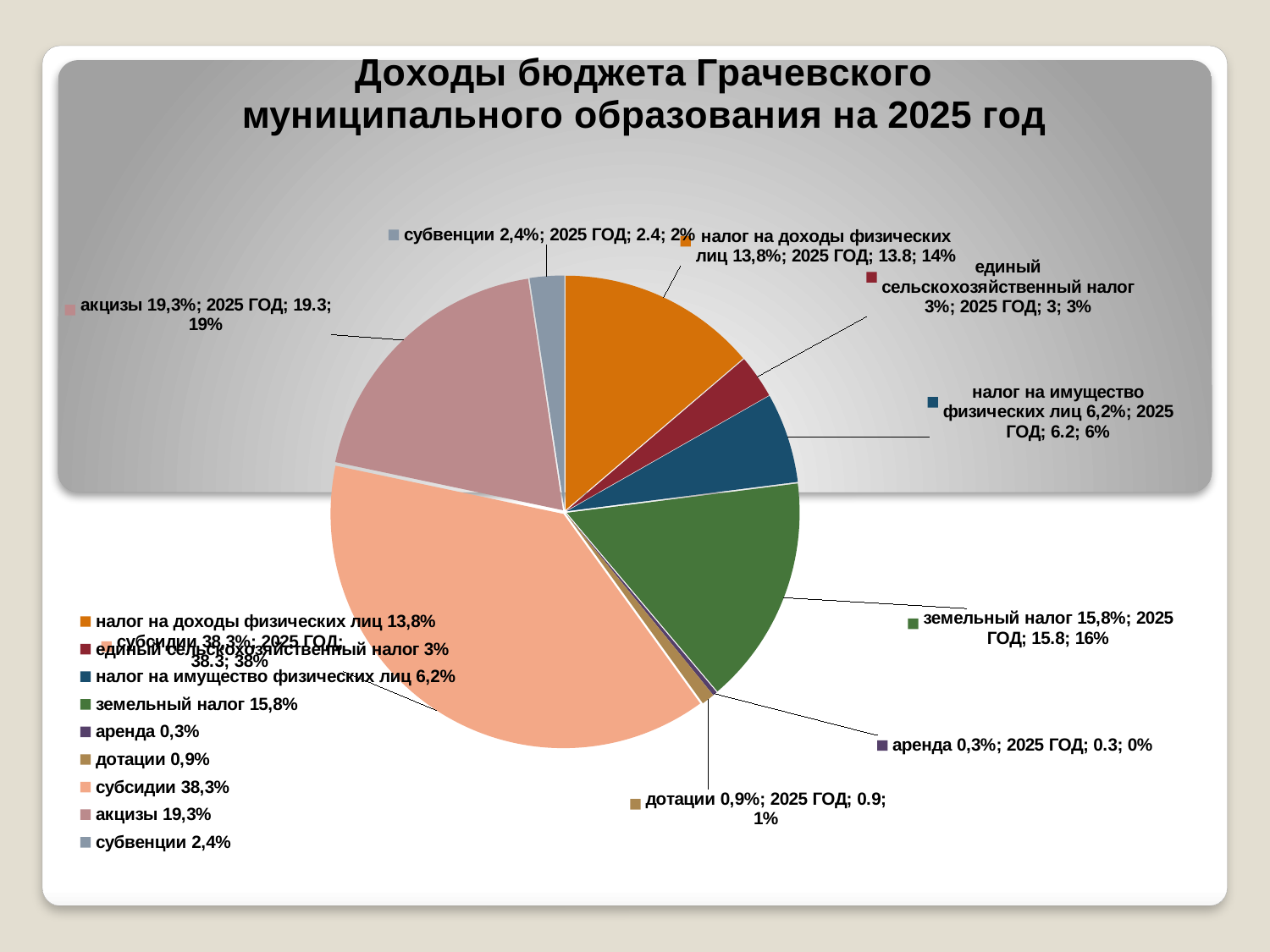
What is the value for земельный налог in the pie chart? 15,8% Which category has the smallest slice of the pie? аренда What is the value for налог на имущество физических лиц? 6,2% What rounded share of the pie does налог на доходы физических лиц represent, according to its data label? 14% Which is larger, акцизы or налог на доходы физических лиц? акцизы What is the title of the chart on the slide? Доходы бюджета Грачевского муниципального образования на 2025 год What kind of chart is shown on the slide? pie chart How many categories (slices) does the pie chart have? 9 What is the difference between the values for акцизы (19,3%) and земельный налог (15,8%)? 3,5% What is the value for субсидии in the pie chart? 38,3% What is the value for дотации in the pie chart? 0,9% Which category has the largest slice of the pie? субсидии